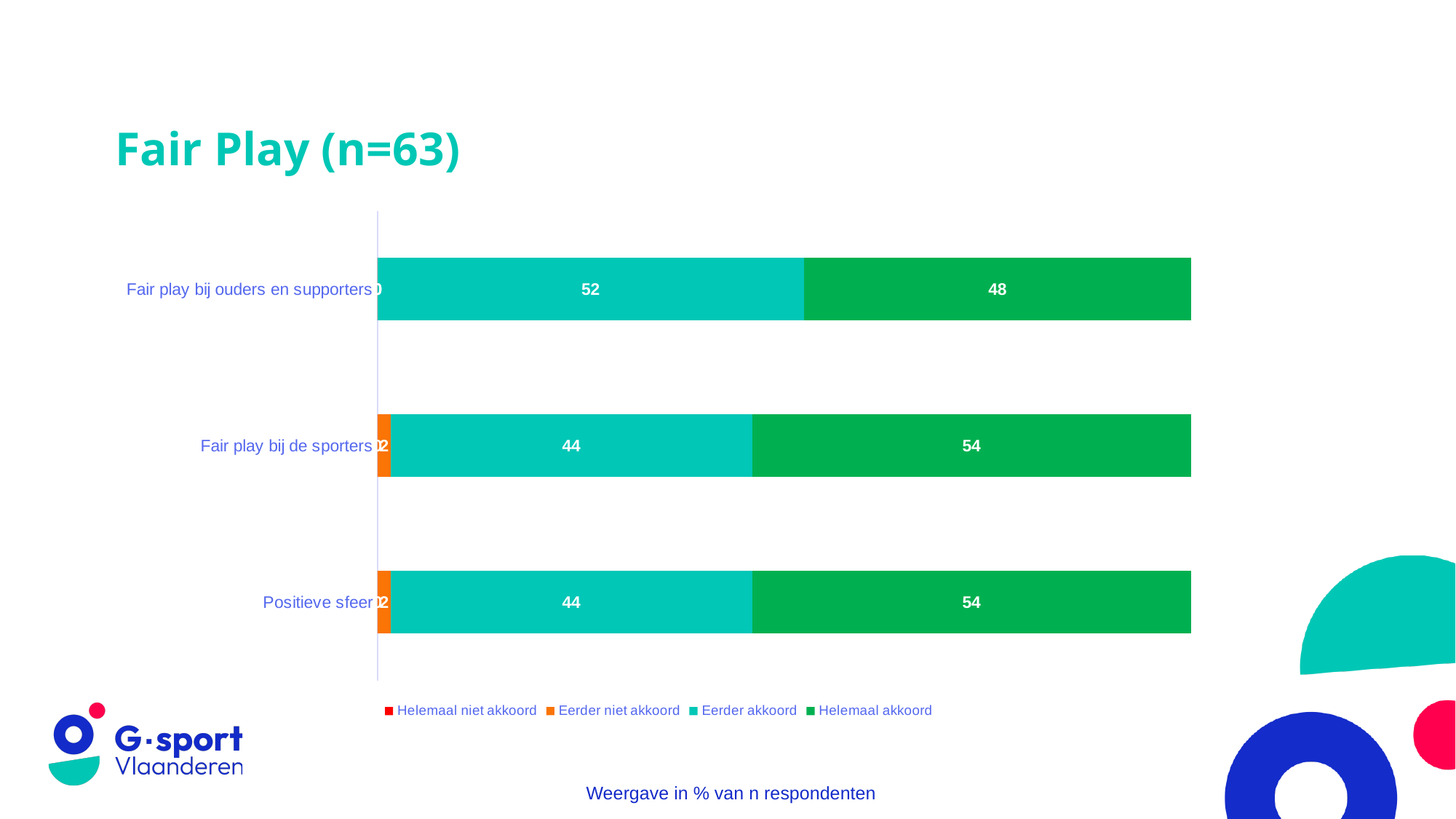
What is the value of "Eerder akkoord" for "Fair play bij de sporters"? 44 For "Fair play bij ouders en supporters", which is larger: "Eerder akkoord" or "Helemaal akkoord"? Eerder akkoord How many series does the legend list? 4 Which category has the lowest value for "Helemaal akkoord"? Fair play bij ouders en supporters What is the title of the slide? Fair Play (n=63) What is the value of "Helemaal akkoord" for "Positieve sfeer"? 54 What kind of chart is shown on the slide? Stacked bar chart Which category has the highest value for "Eerder akkoord"? Fair play bij ouders en supporters For "Fair play bij de sporters", what is the difference between the "Helemaal akkoord" value and the "Eerder akkoord" value? 10 What is the value of "Helemaal akkoord" for "Fair play bij ouders en supporters"? 48 How many categories are shown on the chart? 3 What is the value of "Eerder akkoord" for "Fair play bij ouders en supporters"? 52